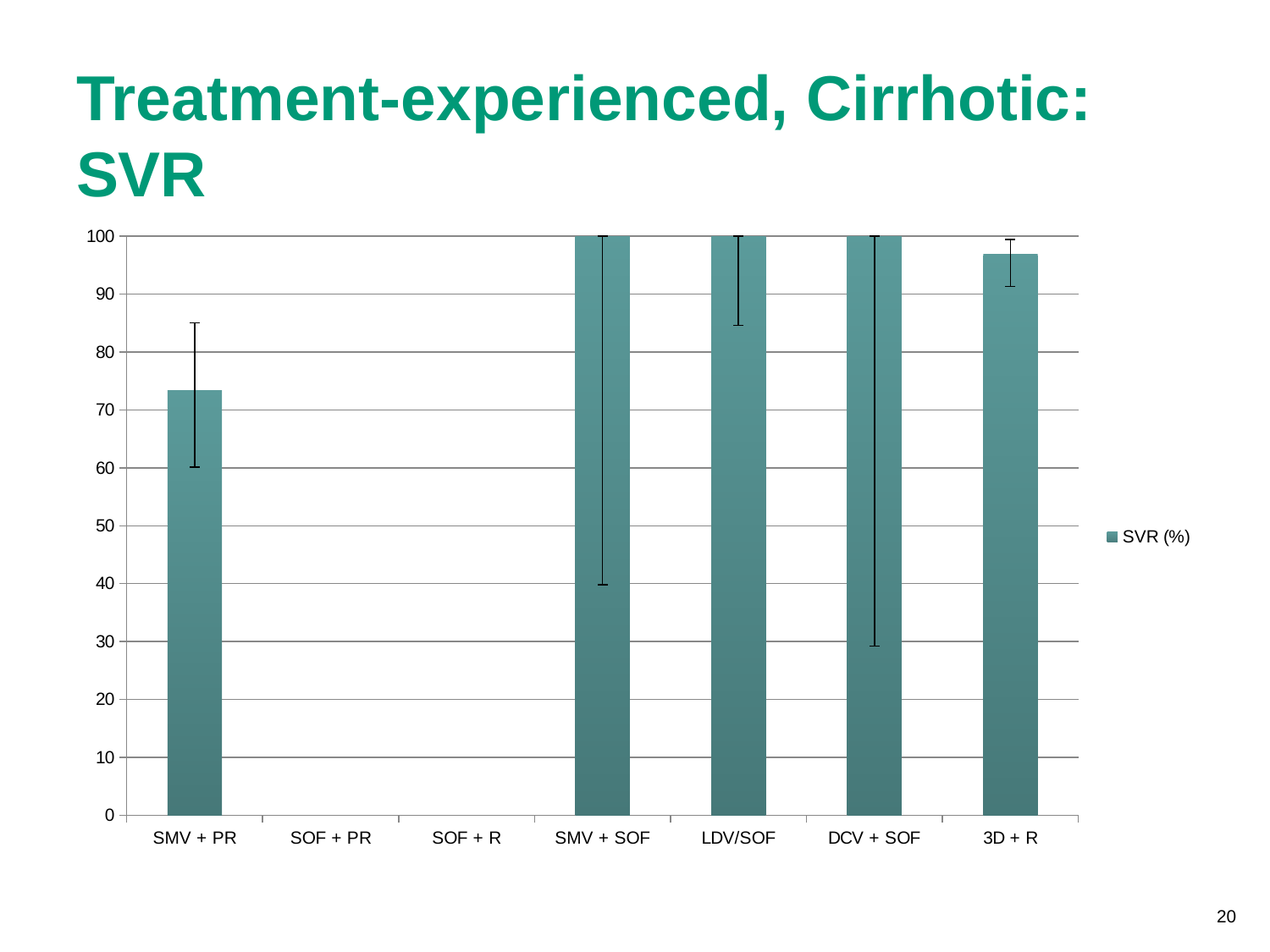
What is the SVR (%) value for SMV + SOF? 100 Is the value for SMV + PR greater or less than 70? greater Which has the larger SVR (%) value, SMV + PR or 3D + R? 3D + R Which category has the shortest visible bar? SMV + PR How many categories are shown on the x axis? 7 What is the SVR (%) value for DCV + SOF? 100 How many series does the legend list? 1 What is the SVR (%) value for LDV/SOF? 100 Is the value for 3D + R greater or less than 90? greater What is the legend entry for the series shown? SVR (%) Is the value for SMV + PR greater or less than 80? less What kind of chart is shown on the slide? bar chart